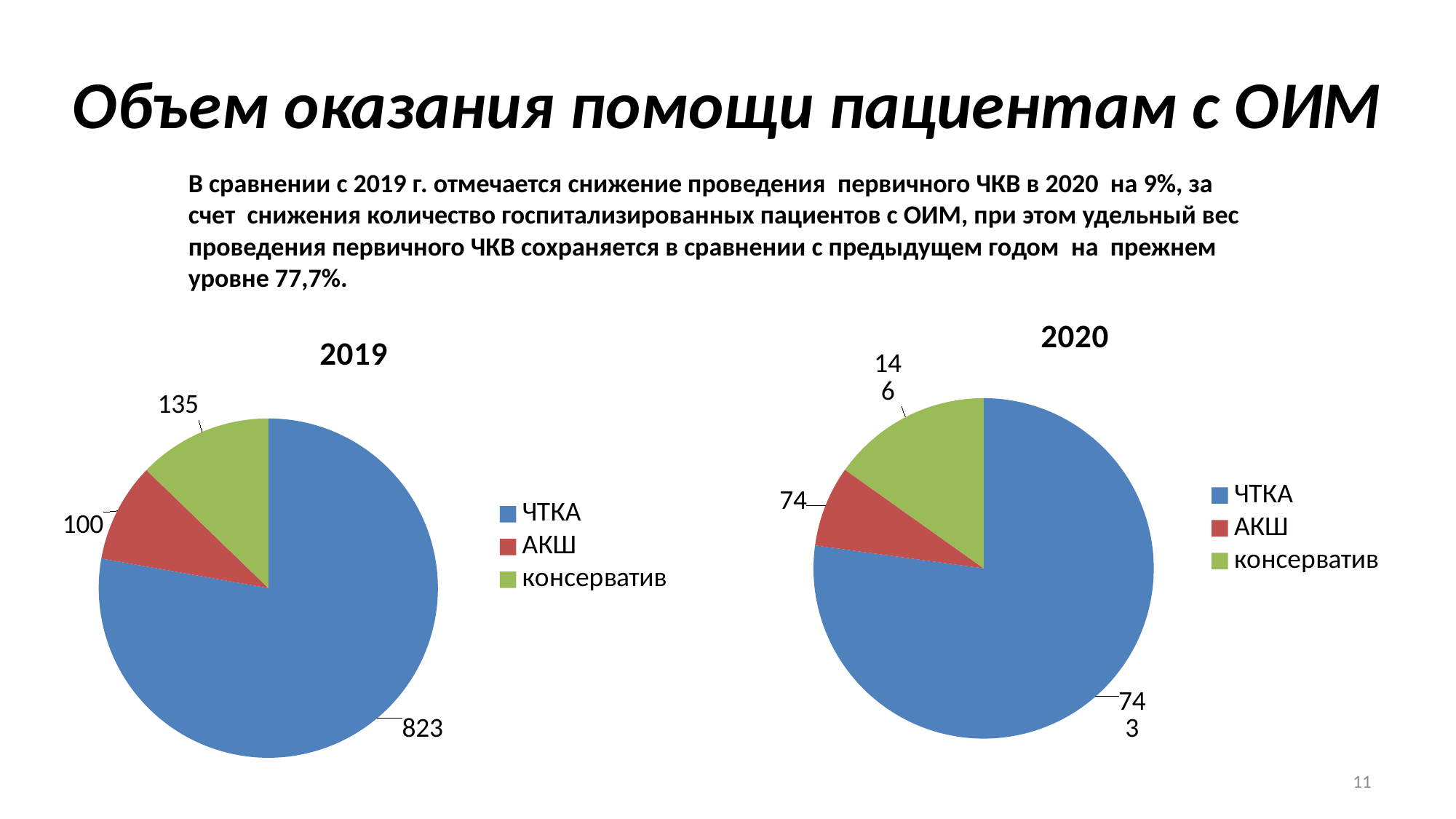
In the 2019 chart, what is the value for АКШ? 100 In the 2019 chart, what is the value for консерватив? 135 How many slices does the 2020 pie chart have? 3 In the 2020 chart, which category has the smallest slice? АКШ In the 2019 chart, which category has the largest slice? ЧТКА In the 2019 chart, what colour is the ЧТКА slice? blue In the 2019 chart, what is the difference between консерватив and АКШ? 35 In the 2020 chart, what is the value for АКШ? 74 What kind of chart is the 2019 chart? pie chart In the 2020 chart, what is the value for ЧТКА? 743 In the 2019 chart, which is larger, консерватив or АКШ? консерватив In the 2019 chart, what is the value for ЧТКА? 823